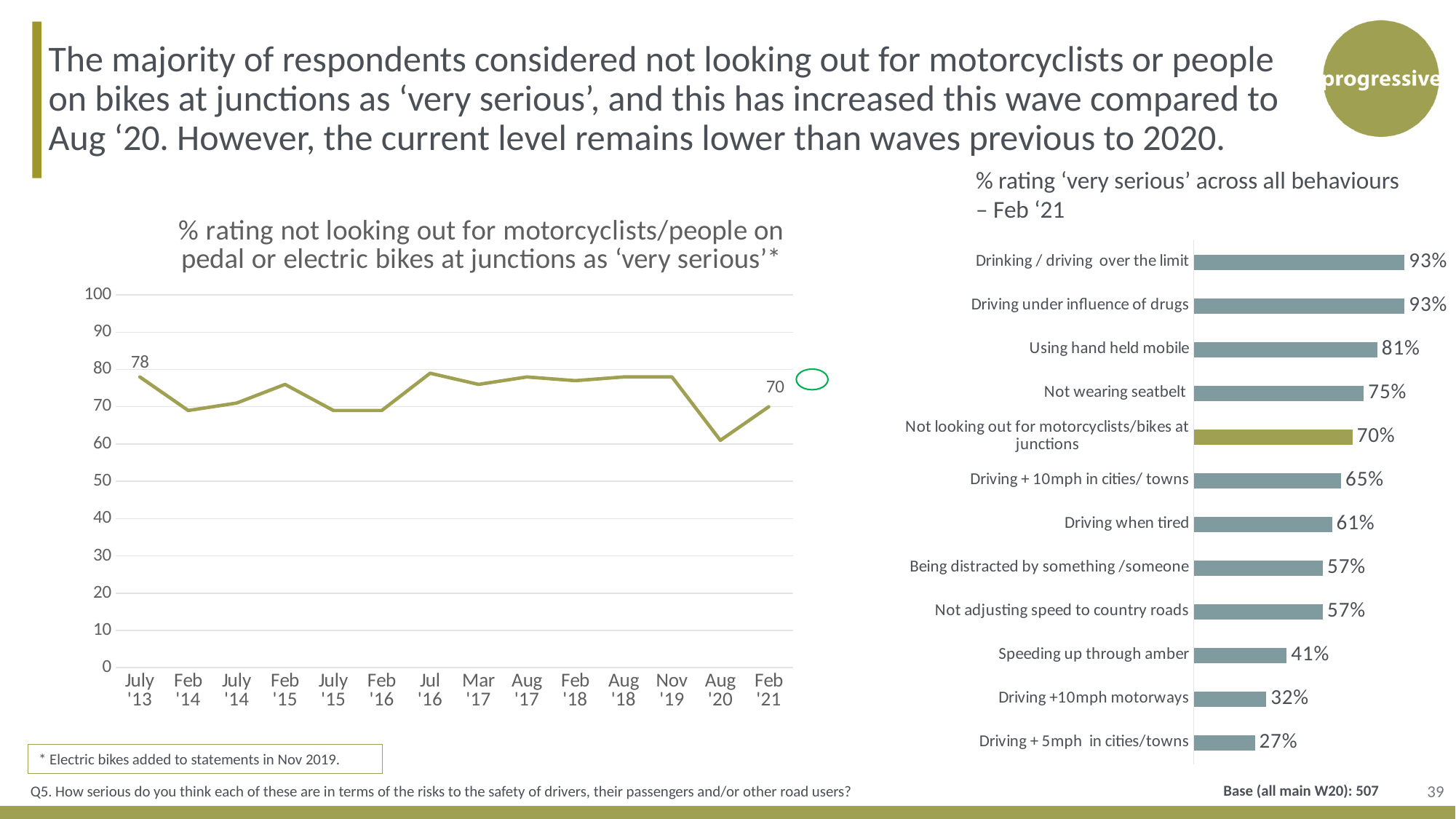
How many time points are plotted in the line chart on the left? 14 In the bar chart on the right, which behaviour has the lowest percentage? Driving + 5mph in cities/towns How many behaviours are listed in the bar chart on the right? 12 In the line chart on the left, is the value for Aug '20 greater or less than 70? less In the line chart on the left, what is the difference between the July '13 value and the Feb '21 value? 8 In the line chart on the left, what is the value for July '13? 78 In the bar chart on the right, which is larger: 'Driving when tired' or 'Driving + 10mph in cities/ towns'? Driving + 10mph in cities/ towns In the line chart on the left, what is the value for Feb '21? 70 In the bar chart on the right, what percentage rated 'Using hand held mobile' as very serious? 81% In the bar chart on the right, what is the difference between 'Using hand held mobile' and 'Not wearing seatbelt'? 6 percentage points What kind of chart is the chart on the left? line chart In the line chart on the left, does the value rise or fall from Aug '20 to Feb '21? rise